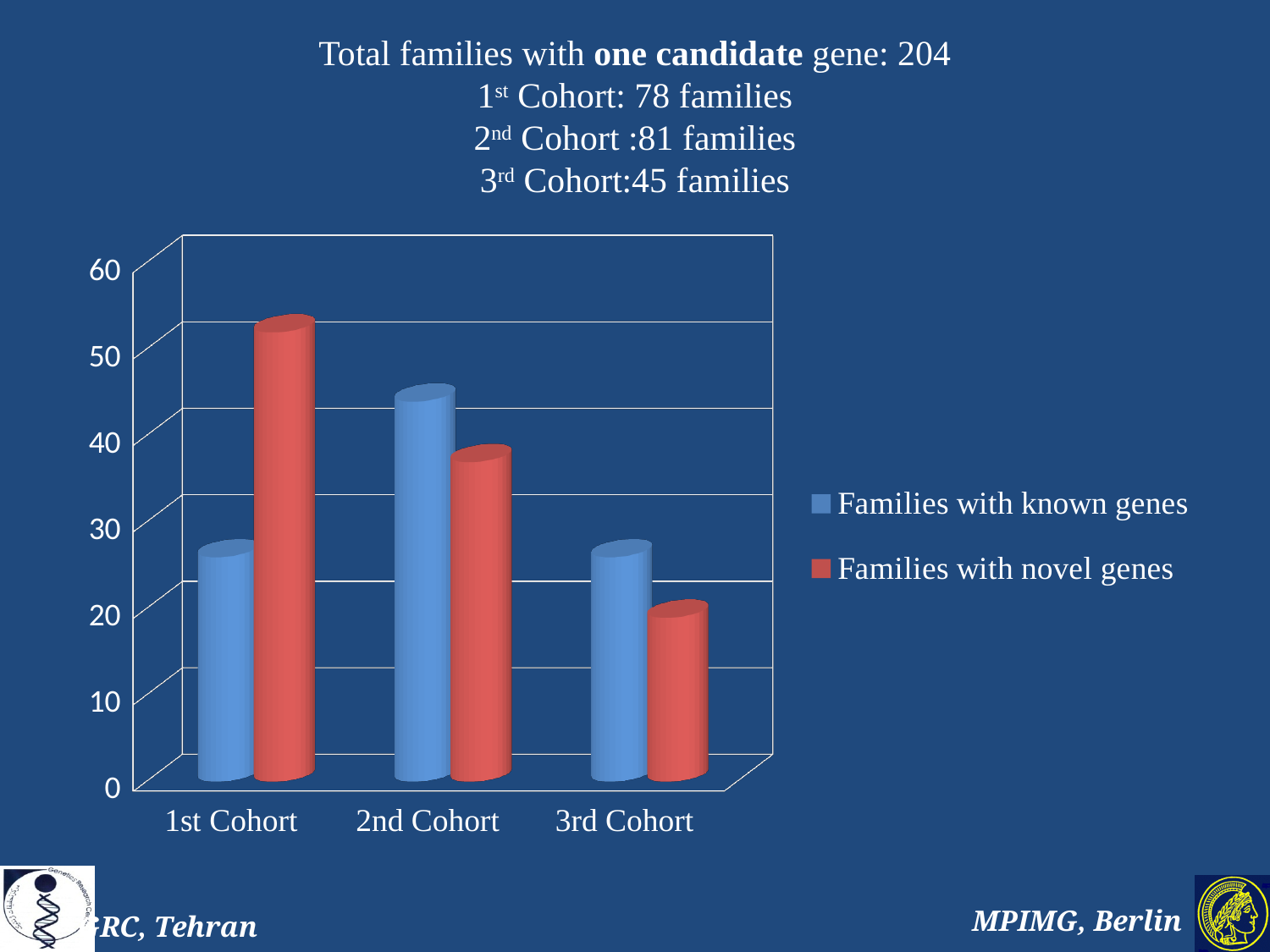
Which cohort has the highest value for Families with novel genes? 1st Cohort Is the value for Families with novel genes in the 3rd Cohort greater or less than 30? less How many cohorts are shown on the x axis of the chart? 3 Which cohort has the highest value for Families with known genes? 2nd Cohort Which cohort has the lowest value for Families with novel genes? 3rd Cohort Which colour represents Families with novel genes in the chart legend? Red What kind of chart is shown on the slide? Bar chart How many series does the chart legend list? 2 In the 1st Cohort, which is larger: Families with known genes or Families with novel genes? Families with novel genes Is the value for Families with known genes in the 2nd Cohort greater or less than 40? greater In the 2nd Cohort, which is larger: Families with known genes or Families with novel genes? Families with known genes Is the value for Families with novel genes in the 1st Cohort greater or less than 40? greater